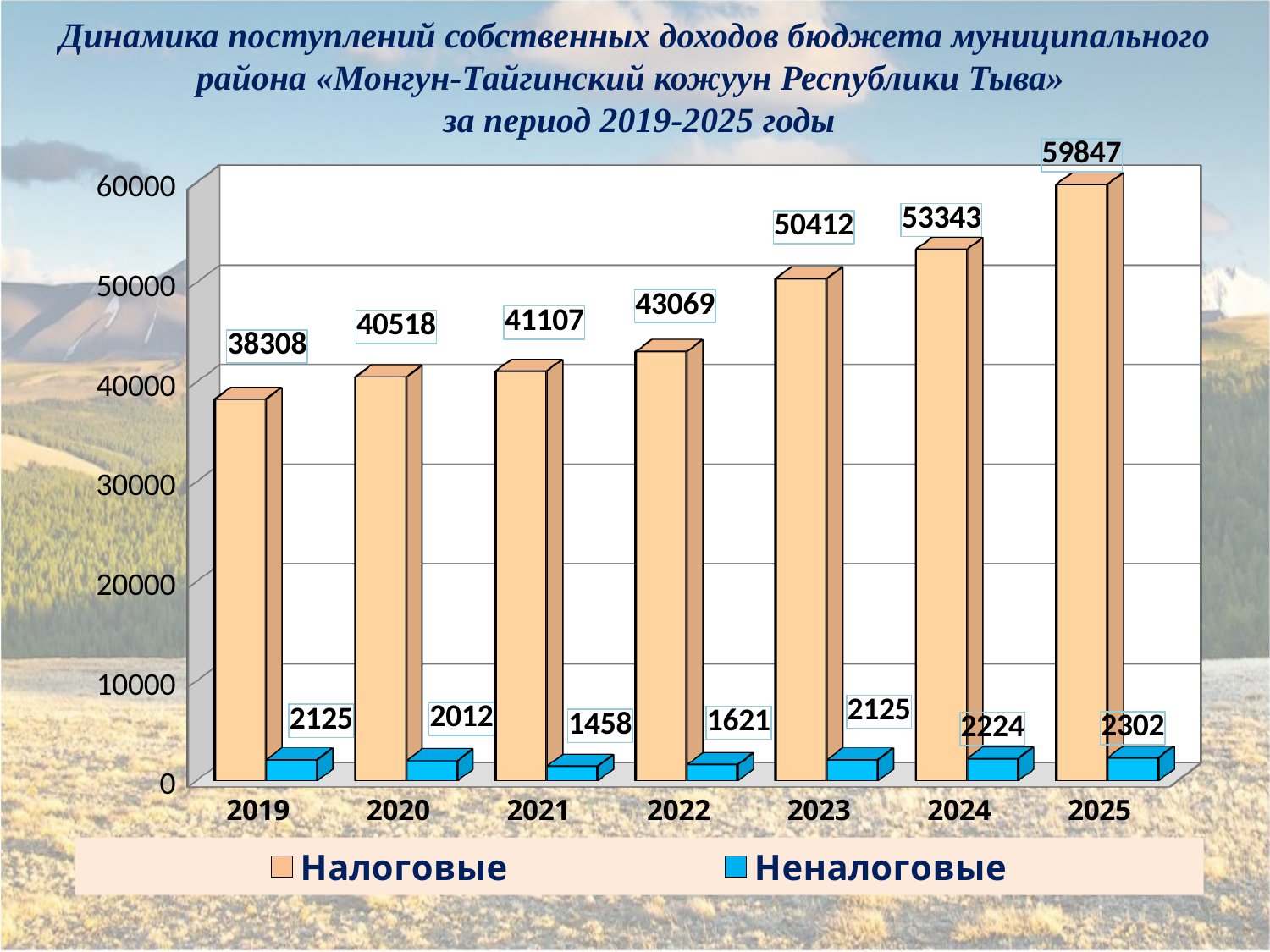
Which is larger, the Неналоговые value for 2020 or for 2022? 2020 Which year has the highest Налоговые value? 2025 What is the value of Налоговые for 2025? 59847 What is the value of Налоговые for 2019? 38308 What is the value of Неналоговые for 2021? 1458 Do the Налоговые values rise or fall from 2019 to 2025? rise What is the difference between the Налоговые values for 2025 and 2024? 6504 How many series does the legend list? 2 What colour are the Неналоговые bars? blue How many years are shown on the x axis? 7 What kind of chart is shown on the slide? bar chart Which year has the lowest Неналоговые value? 2021